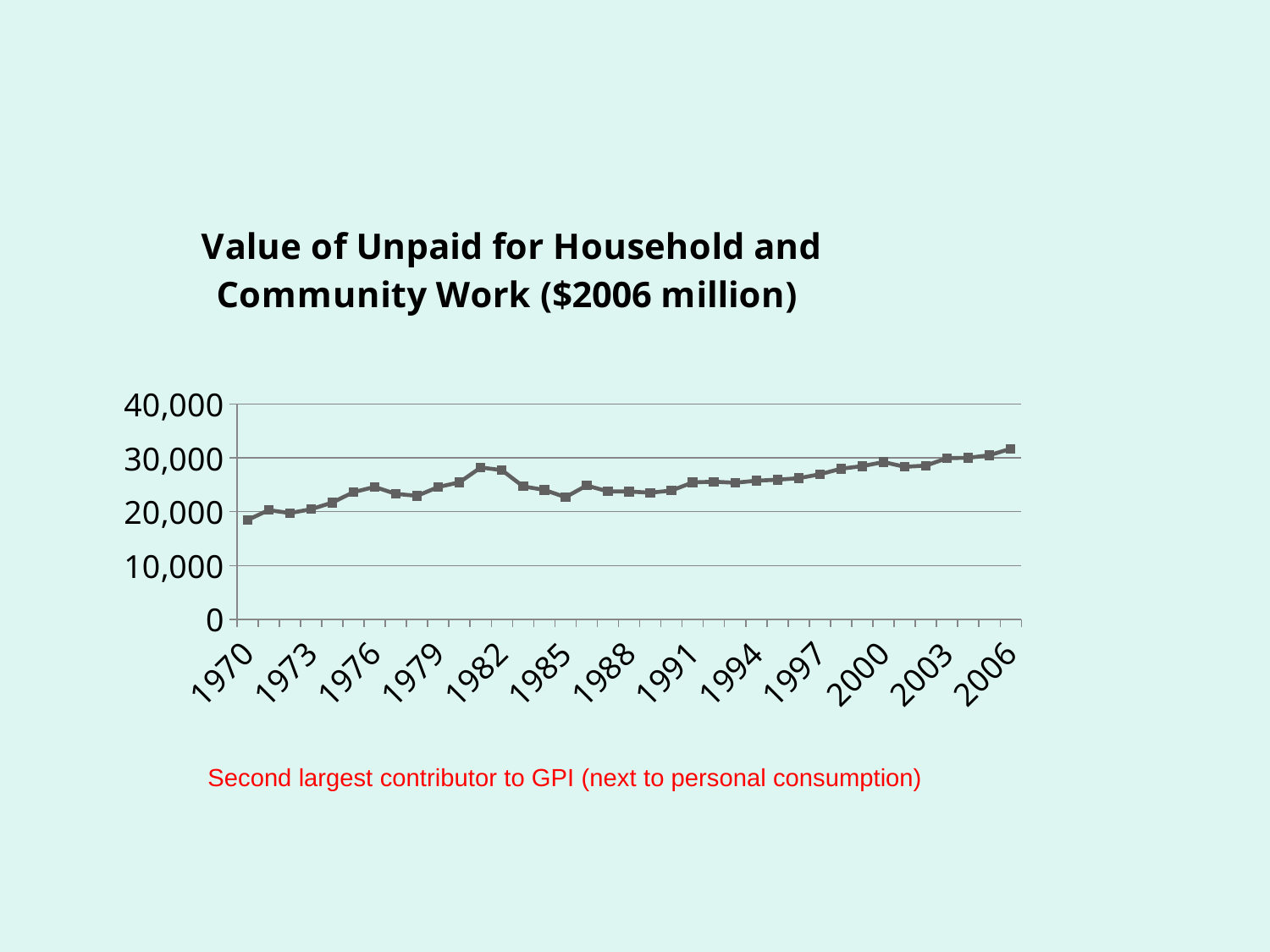
Is the value for 1982 greater or less than 30,000? less Which year has the lowest value on the chart? 1970 What kind of chart is shown on the slide? line chart Which year has the highest value on the chart? 2006 Is the value for 1970 greater or less than 20,000? less Overall, do the values rise or fall from 1970 to 2006? rise Which is larger, the value for 1970 or the value for 2006? 2006 What is the highest value shown on the y axis? 40,000 What is the title of the chart? Value of Unpaid for Household and Community Work ($2006 million) How many year labels are shown on the x axis? 13 Is the value for 1985 greater or less than 20,000? greater